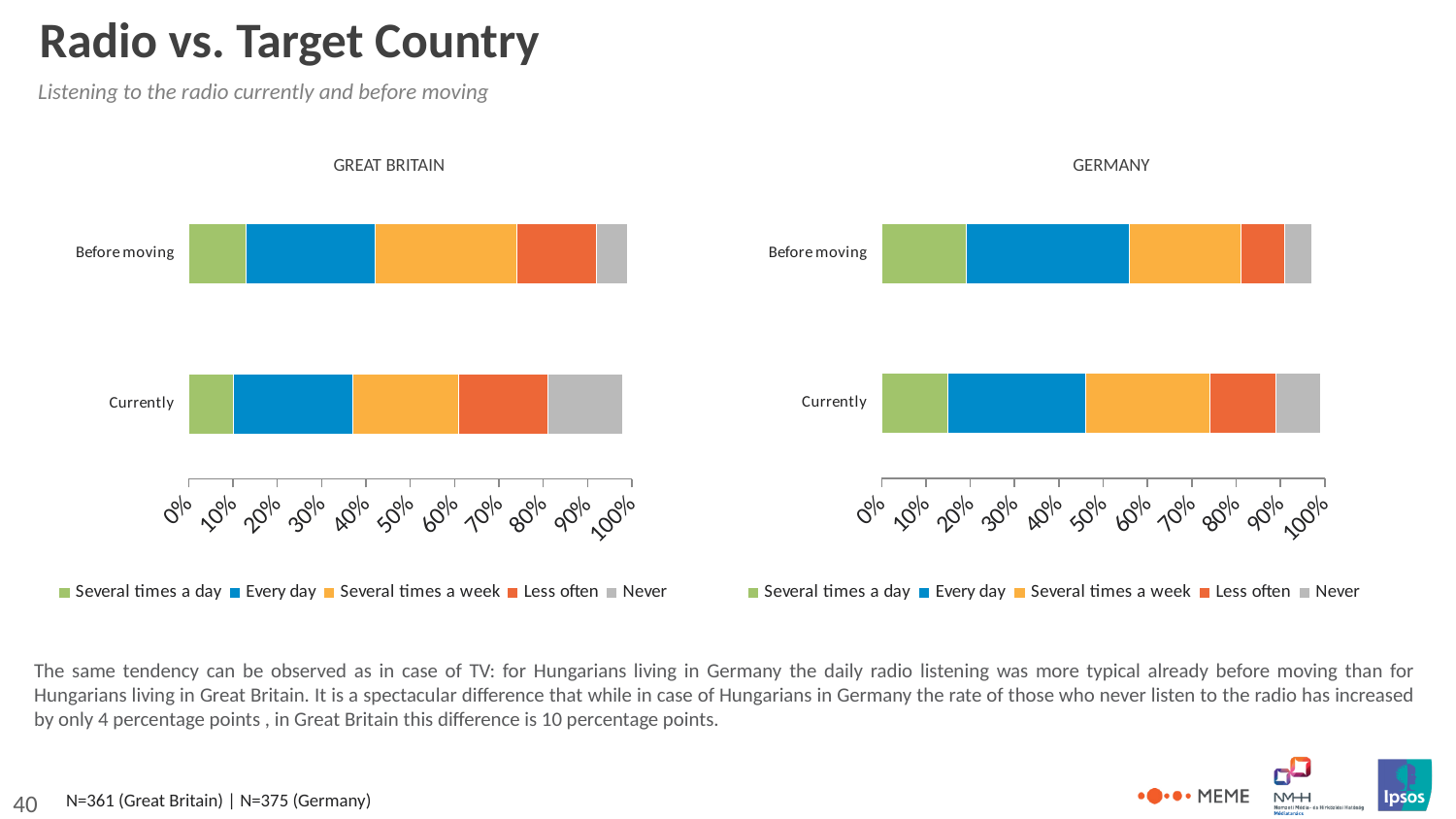
In the Great Britain chart, is the Never segment for Currently greater or less than 10%? greater In the Germany chart, is the Never segment for Before moving greater or less than 10%? less In the Great Britain chart, is the Never segment larger for Before moving or for Currently? Currently How many categories (bars) are shown in the Great Britain chart? 2 How many series does the legend of the Germany chart list? 5 In the Great Britain chart, which series has the smallest segment in the Before moving bar? Never Which colour represents the Never series in the legends? Grey In the Germany chart, which series has the smallest segment in the Before moving bar? Never What kind of chart is used for the Great Britain data? Stacked bar chart In the Germany chart, which series has the largest segment in the Before moving bar? Every day In the Germany chart, is the Every day segment for Before moving greater or less than 30%? greater In the Germany chart, is the Every day segment larger for Before moving or for Currently? Before moving